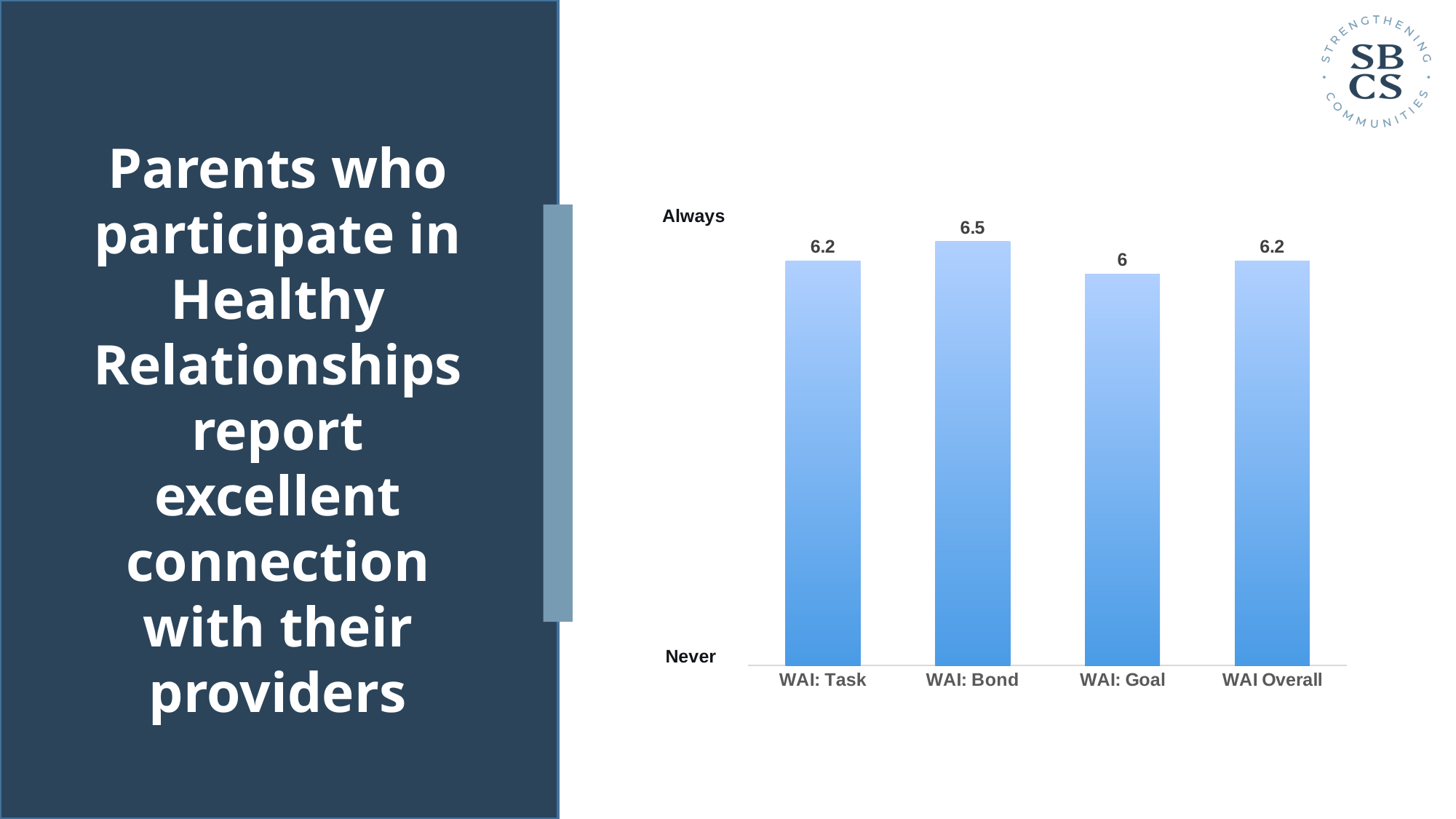
What is the value for WAI: Bond? 6.5 What is the value for WAI Overall? 6.2 Which is larger, the value for WAI: Bond or the value for WAI: Goal? WAI: Bond What are the labels at the top and bottom of the vertical axis? Always and Never What kind of chart is shown on the slide? Bar chart What is the value for WAI: Goal? 6 What is the value for WAI: Task? 6.2 What is the difference between the values for WAI: Bond and WAI: Goal? 0.5 Which category has the lowest value? WAI: Goal How many categories are shown on the chart? 4 What is the difference between the values for WAI: Bond and WAI: Task? 0.3 Which category has the highest value? WAI: Bond